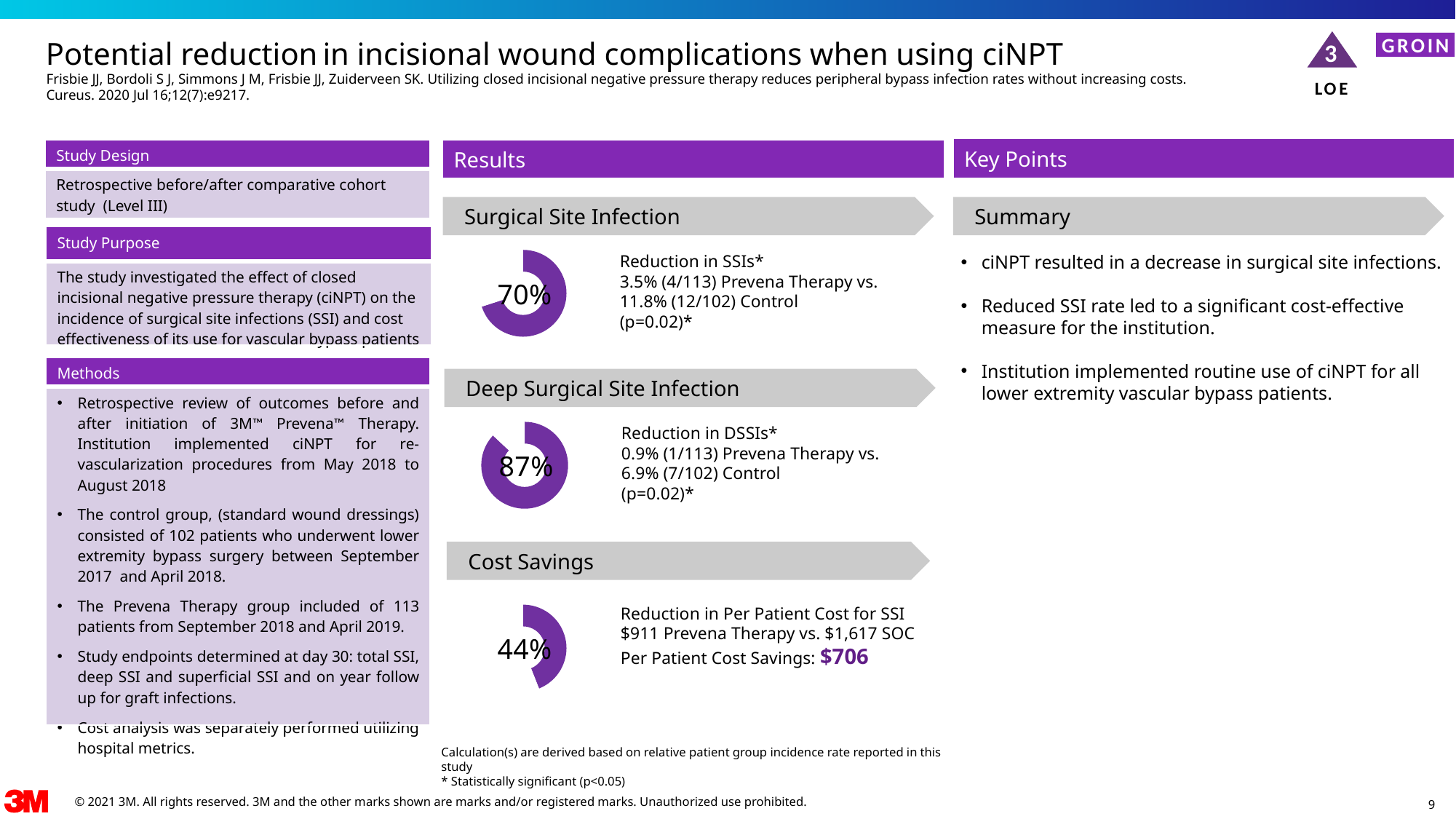
Which of the three donut charts shows the highest percentage? Deep Surgical Site Infection What is the title of the section containing the 44% donut chart? Cost Savings What colour is the filled portion of the donut charts in the Results section? Purple What percentage is shown in the Surgical Site Infection donut chart? 70% What is the difference in percentage points between the Deep Surgical Site Infection donut (87%) and the Surgical Site Infection donut (70%)? 17 Is the value shown in the Cost Savings donut chart greater or less than 50%? less Is the percentage in the Deep Surgical Site Infection donut chart larger or smaller than the percentage in the Surgical Site Infection donut chart? Larger What kind of chart is used to display the reduction in SSIs under Surgical Site Infection? Donut chart What percentage is shown in the Deep Surgical Site Infection donut chart? 87% How many donut charts are shown in the Results section of the slide? 3 What percentage is shown in the Cost Savings donut chart? 44% Which of the three donut charts shows the lowest percentage? Cost Savings